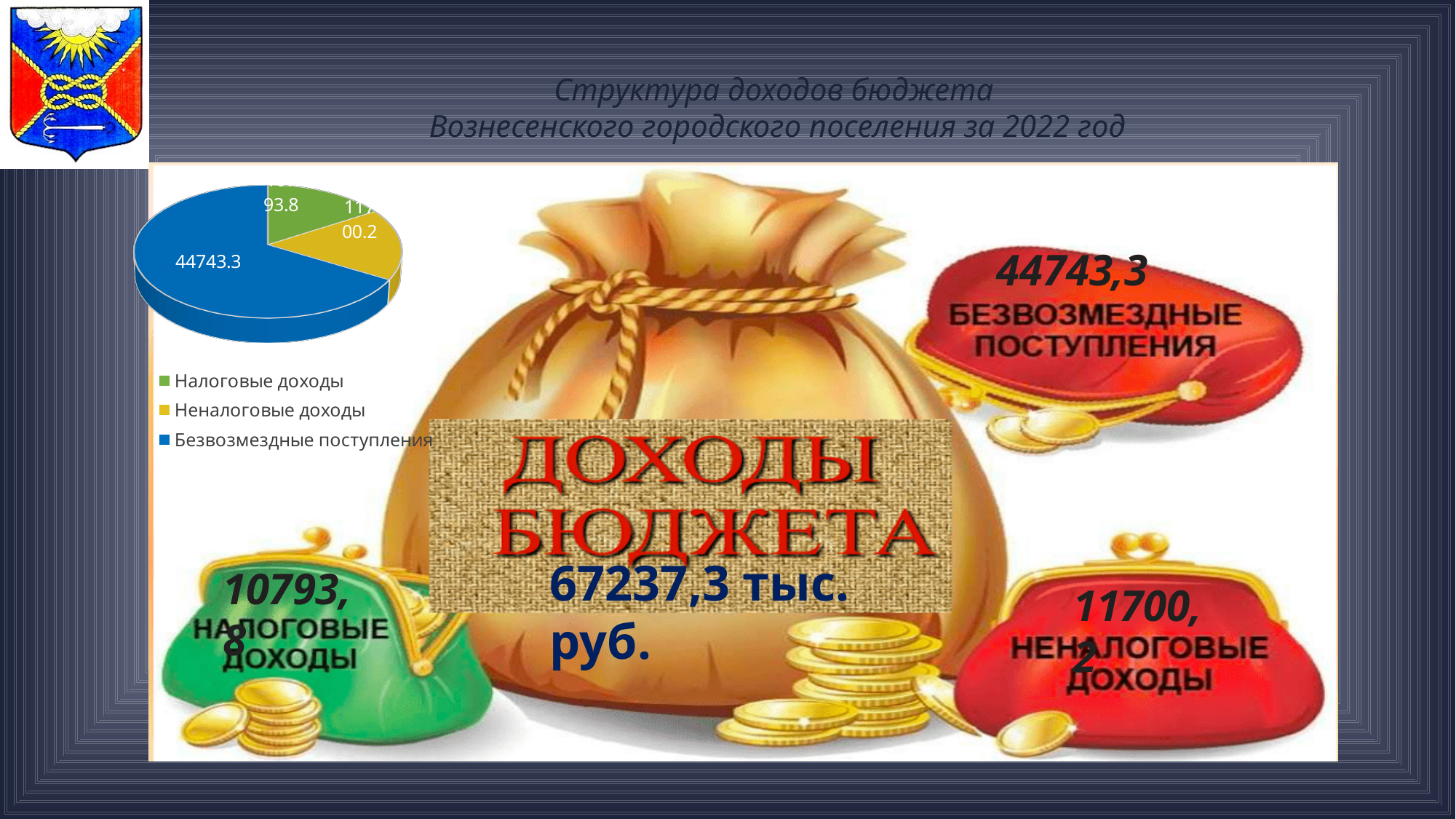
Does the slice for Безвозмездные поступления take up more or less than half of the pie chart? More Which category has the largest slice in the pie chart? Безвозмездные поступления How many categories does the pie chart's legend list? 3 What colour is the slice for Налоговые доходы in the pie chart? Green Which is larger in the pie chart: Безвозмездные поступления or Налоговые доходы? Безвозмездные поступления What kind of chart is shown on the slide? Pie chart How many slices does the pie chart have? 3 What colour is the slice for Безвозмездные поступления in the pie chart? Blue What is the value shown for Безвозмездные поступления in the pie chart? 44743.3 Which is larger in the pie chart: Безвозмездные поступления or Неналоговые доходы? Безвозмездные поступления